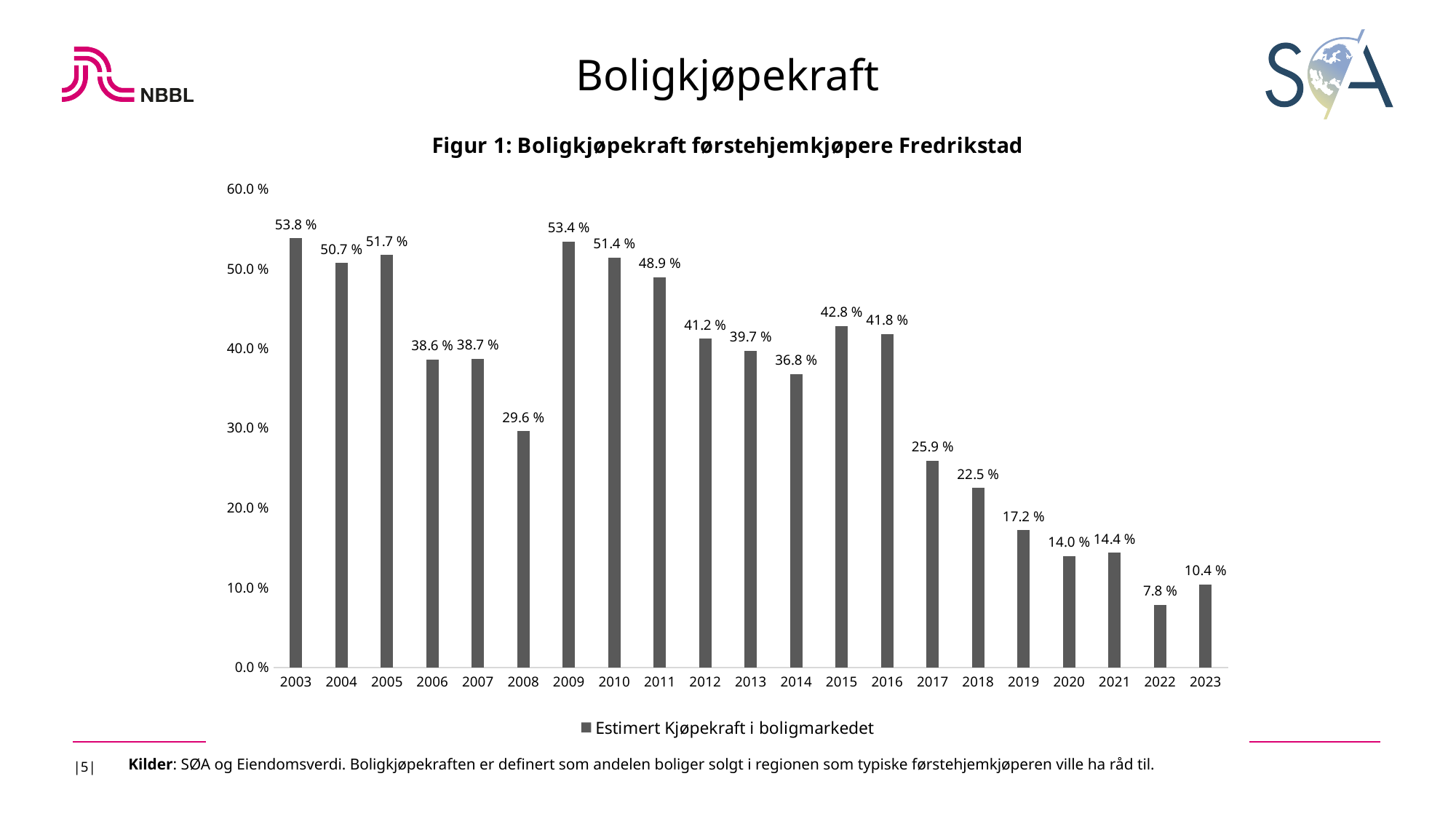
What kind of chart is shown? bar chart Which year has the highest value? 2003 Which year has the lowest value? 2022 Is the value for 2008 greater or less than 30.0 %? less What is the value for 2003? 53.8 % What is the value for 2022? 7.8 % What is the difference between the values for 2003 and 2023? 43.4 % How many series does the legend list? 1 What is the legend entry for the series? Estimert Kjøpekraft i boligmarkedet What is the value for 2015? 42.8 % How many years are shown on the x axis? 21 Which is larger, the value for 2009 or the value for 2010? 2009